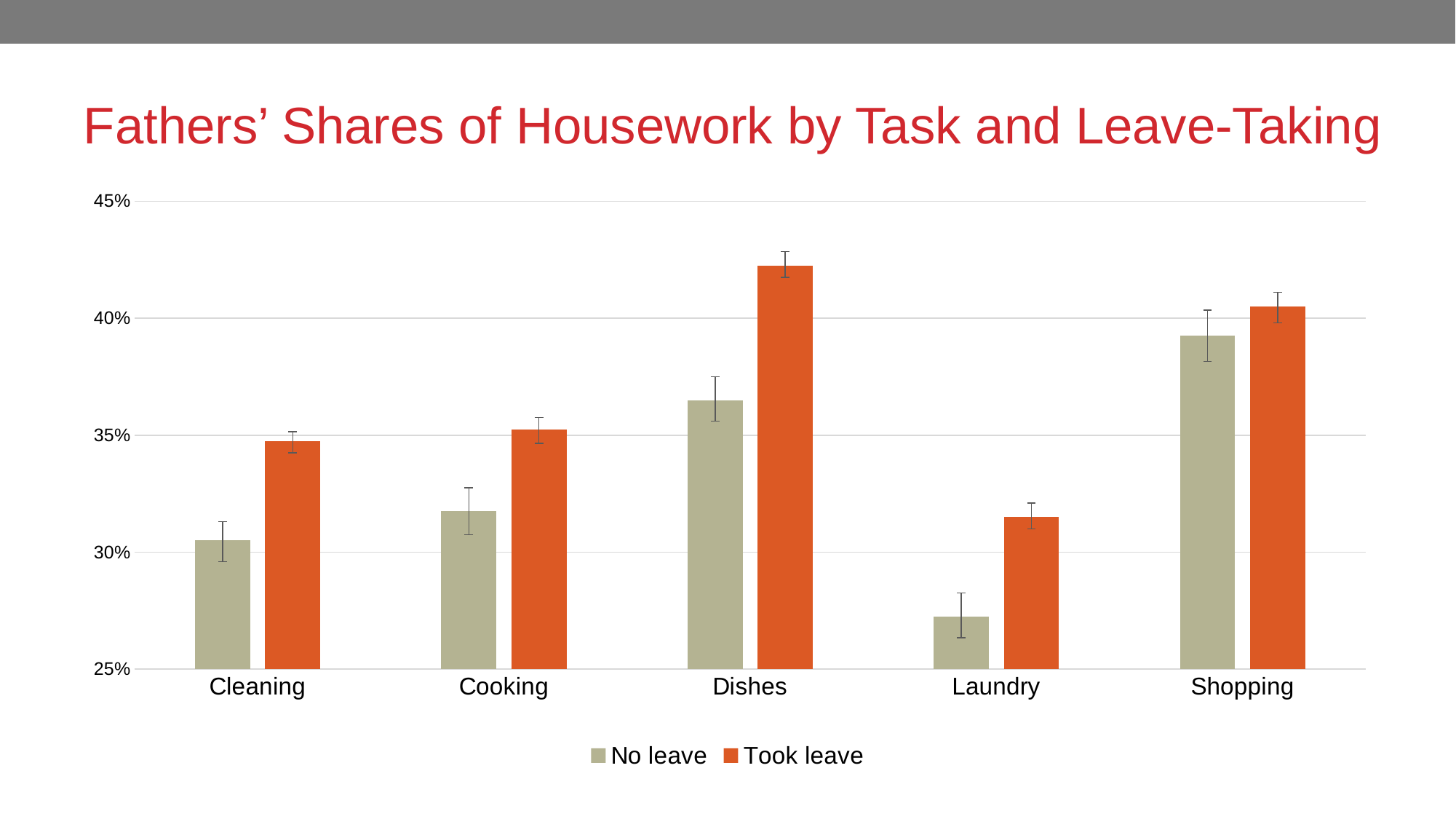
Which task has the lowest value for the Took leave series? Laundry How many task categories are shown on the x axis? 5 Is the Took leave value for Dishes greater or less than 40%? greater What is the title of the chart? Fathers' Shares of Housework by Task and Leave-Taking Which task has the lowest value for the No leave series? Laundry What kind of chart is shown on the slide? bar chart Which task has the highest value for the Took leave series? Dishes For Laundry, which is larger: the No leave value or the Took leave value? Took leave How many series does the legend list? 2 Is the No leave value for Dishes greater or less than 35%? greater Which task has the highest value for the No leave series? Shopping Is the No leave value for Laundry greater or less than 30%? less